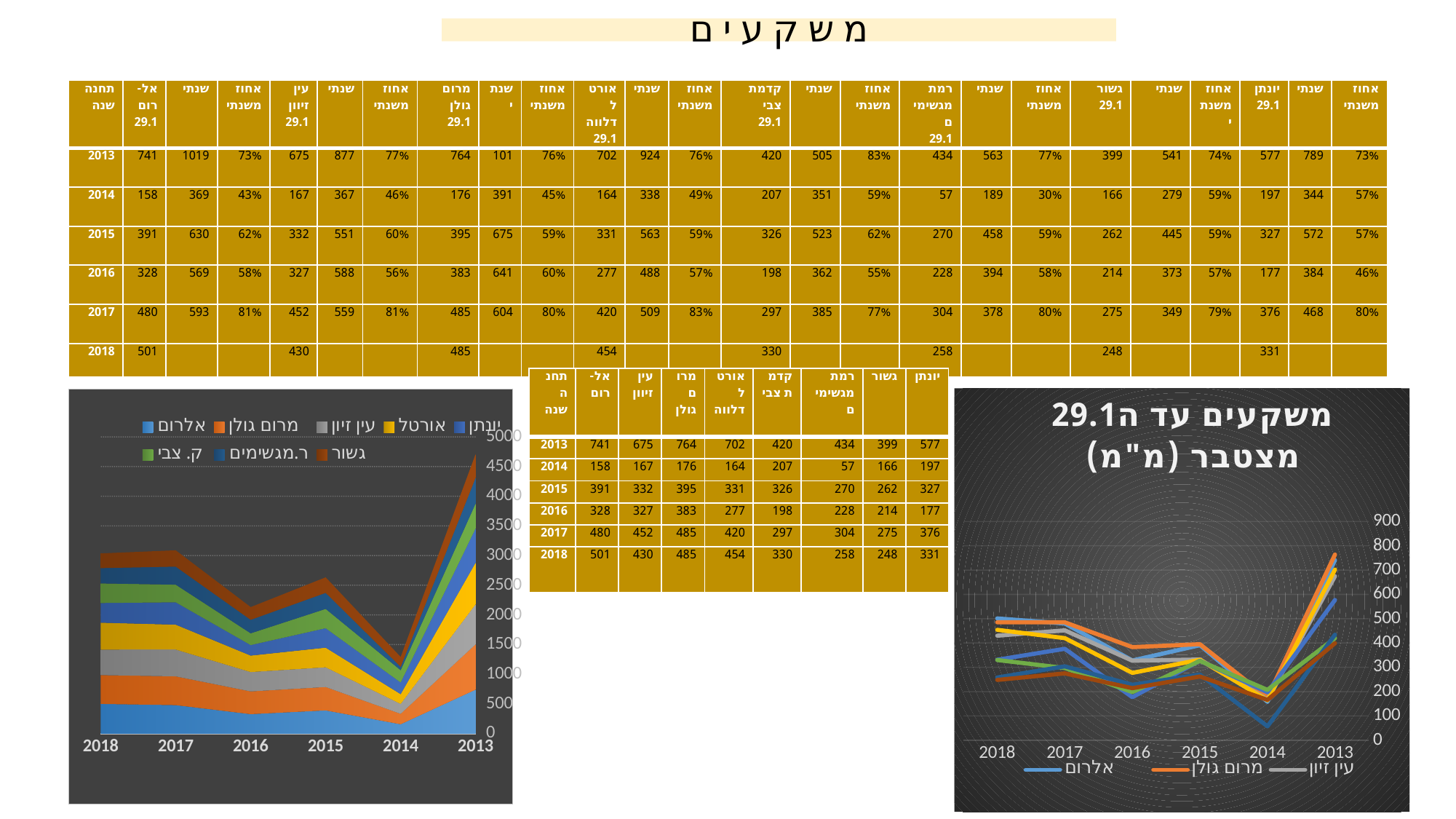
What kind of chart is the chart at the bottom right of the slide? line chart In the bottom-left area chart, which year has the highest stacked total? 2013 What is the highest value shown on the y axis of the bottom-right line chart? 900 In the bottom-left area chart, is the stacked total for 2013 greater or less than 4000? greater How many series does the legend of the bottom-left area chart list? 8 What is the title of the bottom-right line chart? משקעים עד ה29.1 מצטבר (מ"מ) In the bottom-left area chart, is the stacked total for 2014 greater or less than 1500? less How many years are shown on the x axis of the bottom-left area chart? 6 In the bottom-right line chart, is the value for מרום גולן in 2013 greater or less than 700? greater What kind of chart is the chart at the bottom left of the slide? area chart In the bottom-left area chart, which year has the lowest stacked total? 2014